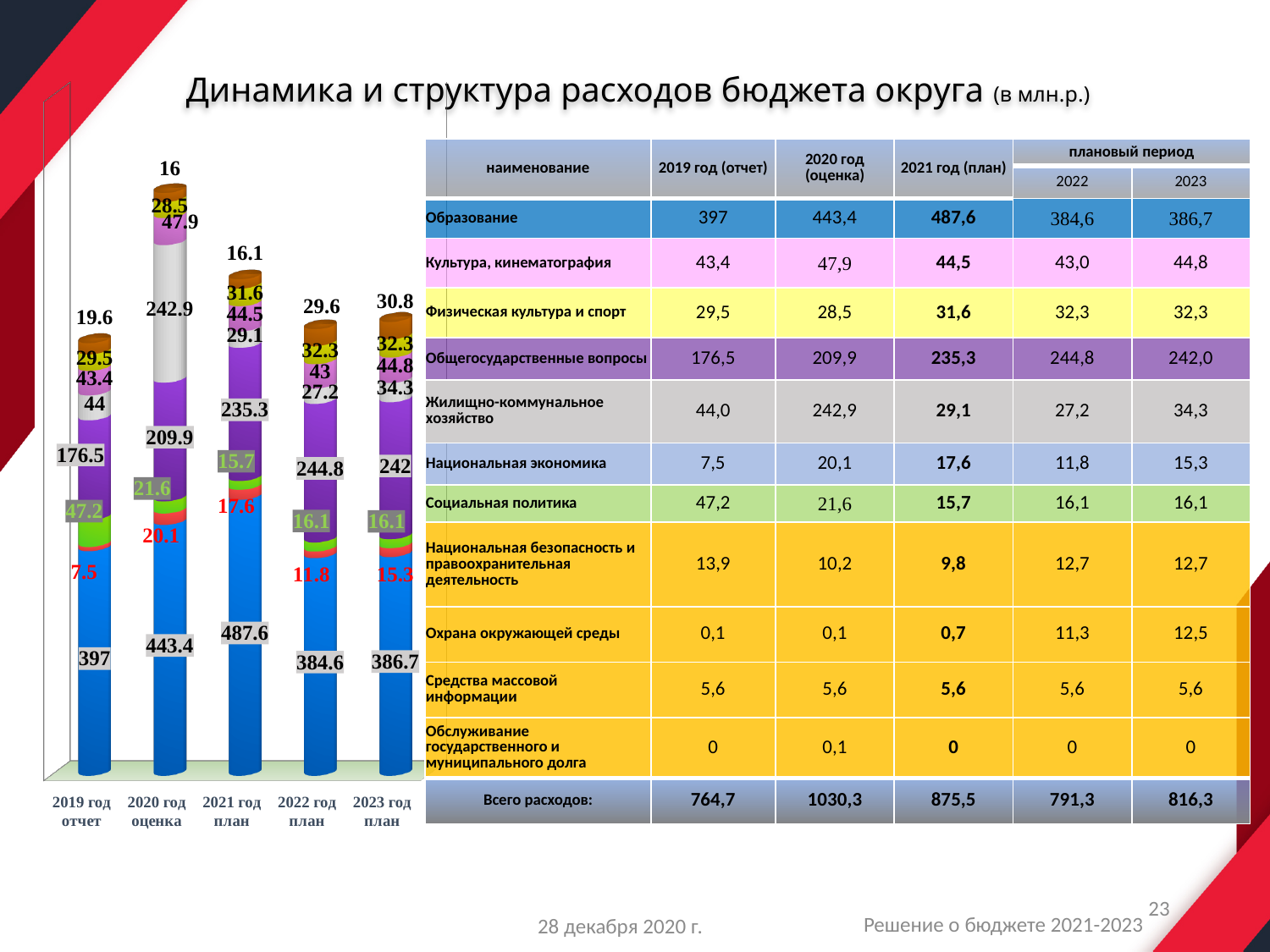
What is the difference between the bottom (blue) segment values for 2021 год план and 2020 год оценка? 44.2 What is the total of the stacked bar for 2019 год отчет, summing its printed segment labels? 764.7 What is the value printed on the bottom (blue) segment of the bar for 2021 год план? 487.6 Which bar has the smallest bottom (blue) segment? 2022 год план What value is printed above the top of the bar for 2023 год план? 30.8 Which bar has the larger grey segment, 2020 год оценка or 2021 год план? 2020 год оценка Which bar has the largest bottom (blue) segment? 2021 год план What kind of chart is shown on the left of the slide? Stacked bar chart What value is printed on the bottom (blue) segment of the bar for 2019 год отчет? 397 What is the difference between the purple segment values for 2022 год план (244.8) and 2021 год план (235.3)? 9.5 How many bars are shown in the chart? 5 What value is printed on the large grey segment of the bar for 2020 год оценка? 242.9